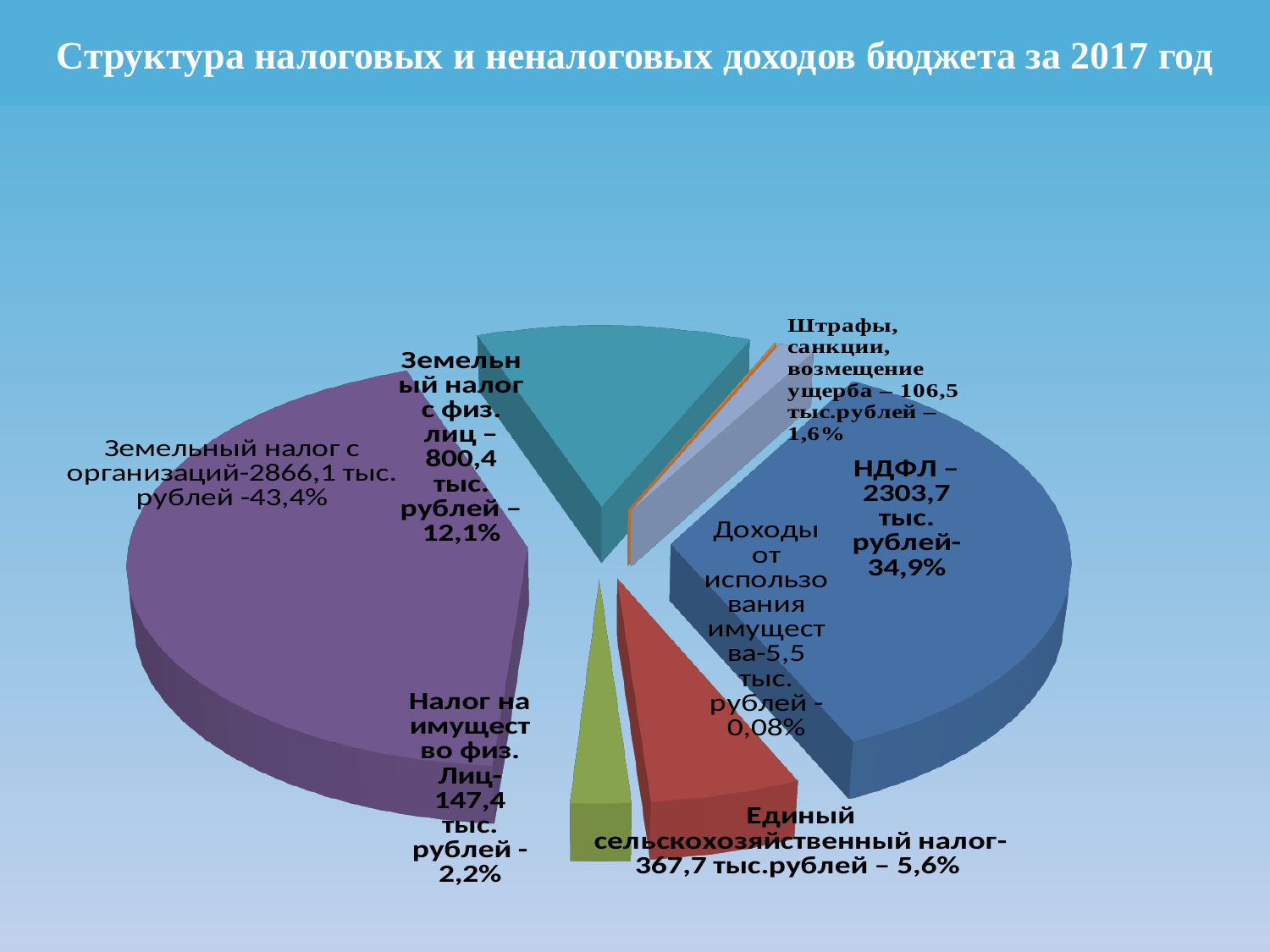
What is the value for НДФЛ? 2303,7 тыс. рублей Which category has the largest slice of the pie? Земельный налог с организаций What is the value for Штрафы, санкции, возмещение ущерба? 106,5 тыс.рублей What share of the pie does Земельный налог с организаций represent? 43,4% What share of the pie does Единый сельскохозяйственный налог represent? 5,6% Which is larger: Земельный налог с физ. лиц or Налог на имущество физ. лиц? Земельный налог с физ. лиц What is the difference in percentage share between Земельный налог с организаций and НДФЛ? 8,5% What percentage share does Налог на имущество физ. лиц have? 2,2% How many slices does the pie chart have? 7 Which category has the smallest slice of the pie? Доходы от использования имущества What kind of chart is shown on the slide? Pie chart What is the title of the chart on the slide? Структура налоговых и неналоговых доходов бюджета за 2017 год